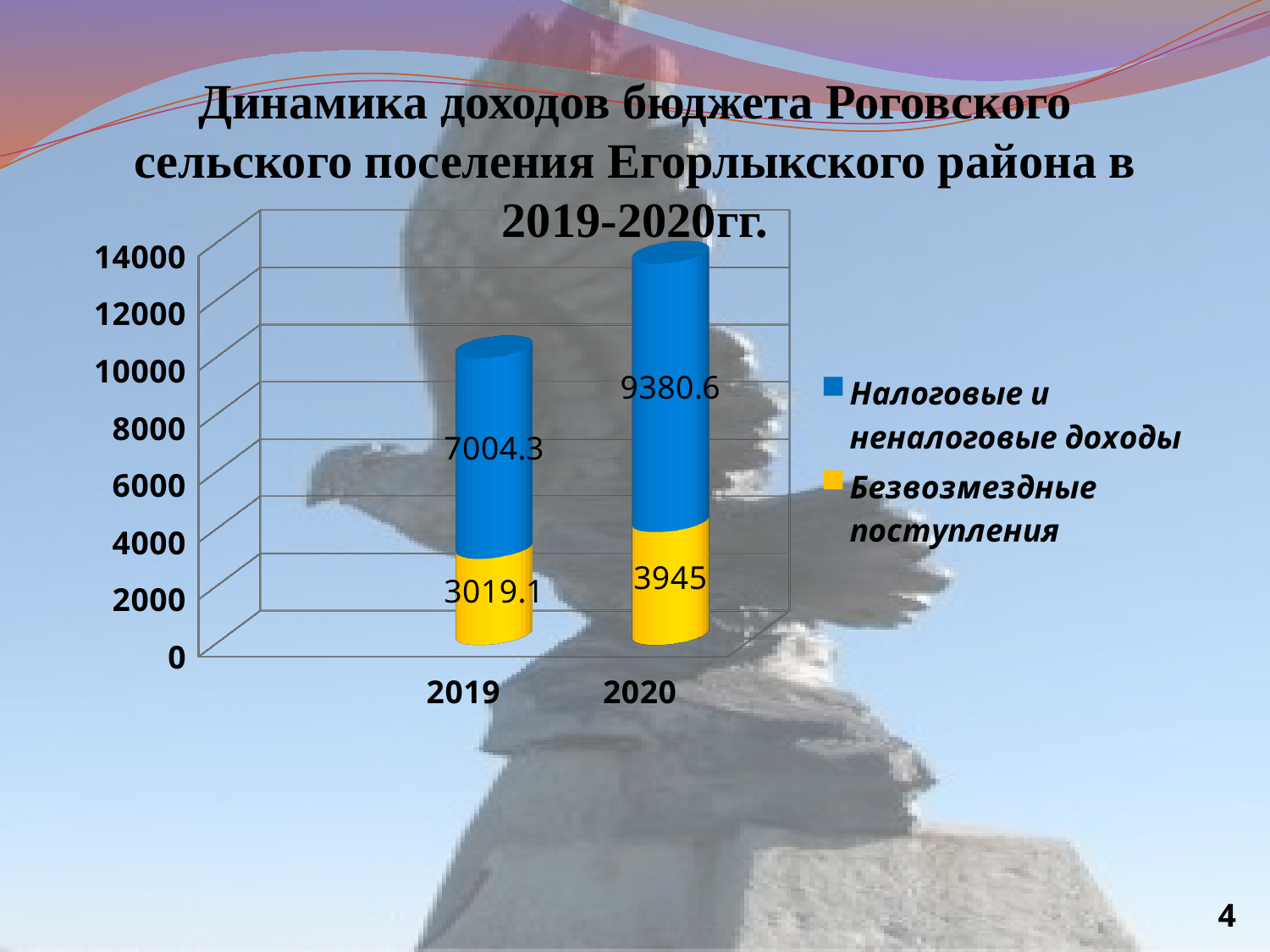
Which year has the lower value for Безвозмездные поступления? 2019 What is the value of Безвозмездные поступления for 2020? 3945 What kind of chart is shown on the slide? Stacked bar chart By how much did Налоговые и неналоговые доходы increase from 2019 to 2020? 2376.3 What is the value of Налоговые и неналоговые доходы for 2019? 7004.3 What is the value of Безвозмездные поступления for 2019? 3019.1 What is the total of the stacked bar for 2020? 13325.6 What is the value of Налоговые и неналоговые доходы for 2020? 9380.6 What is the difference between Безвозмездные поступления in 2020 and in 2019? 925.9 What is the total of the stacked bar for 2019? 10023.4 How many series does the legend list? 2 Which year has the higher value for Налоговые и неналоговые доходы? 2020